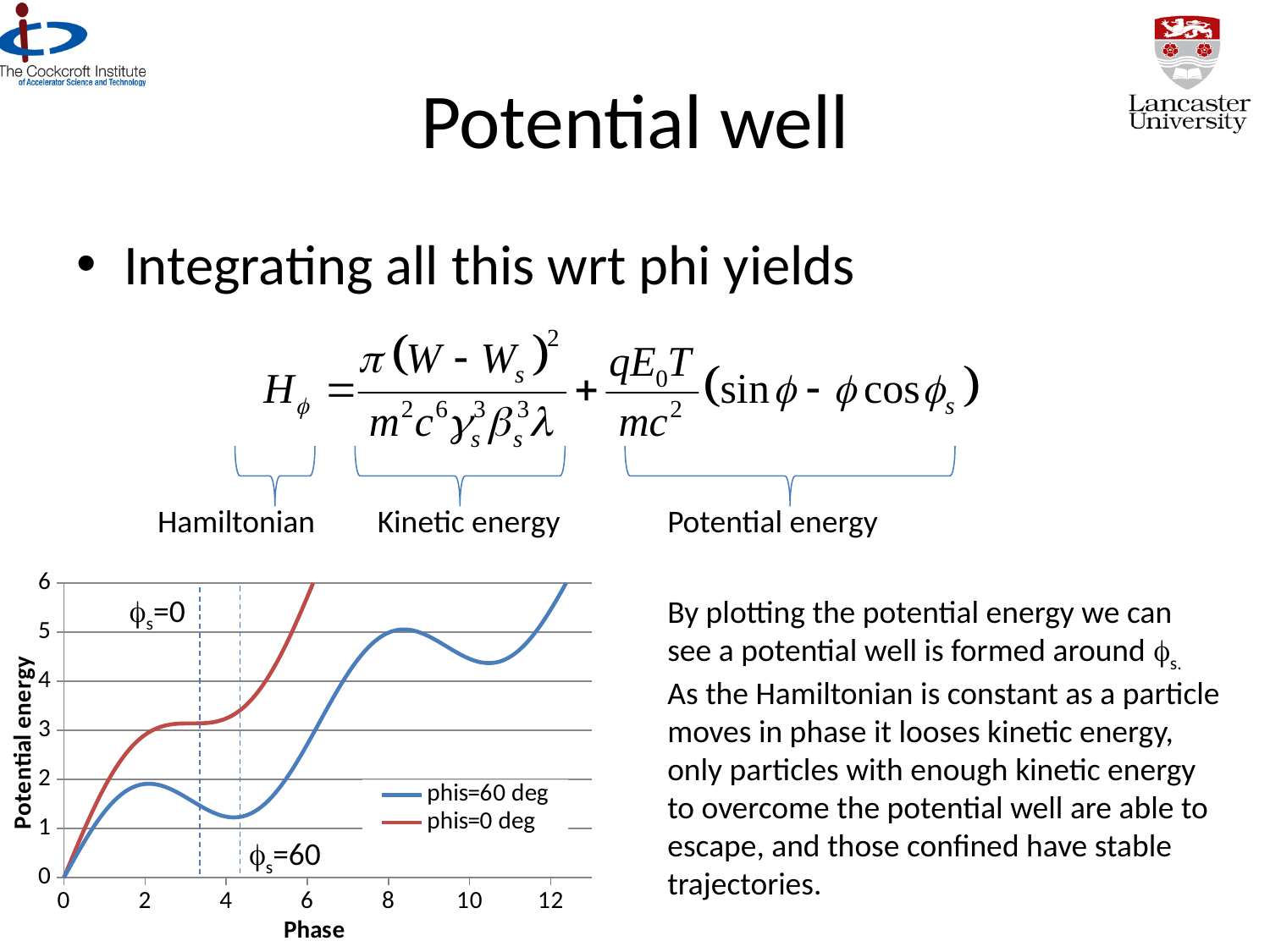
How many series does the chart legend list? 2 Is the value of the phis=0 deg series at phase 4 greater or less than 3? greater Is the value of the phis=60 deg series at phase 10 greater or less than 4? greater Does the phis=60 deg series rise or fall between phase 2 and phase 4? fall Which series is plotted in red? phis=0 deg Is the value of the phis=60 deg series at phase 4 greater or less than 2? less What kind of chart is shown on the slide? line chart What are the two series named in the chart legend? phis=60 deg and phis=0 deg Does the phis=60 deg series rise or fall between phase 4 and phase 8? rise At phase 4, which series has the larger potential energy, phis=60 deg or phis=0 deg? phis=0 deg What is the title of the chart's vertical axis? Potential energy